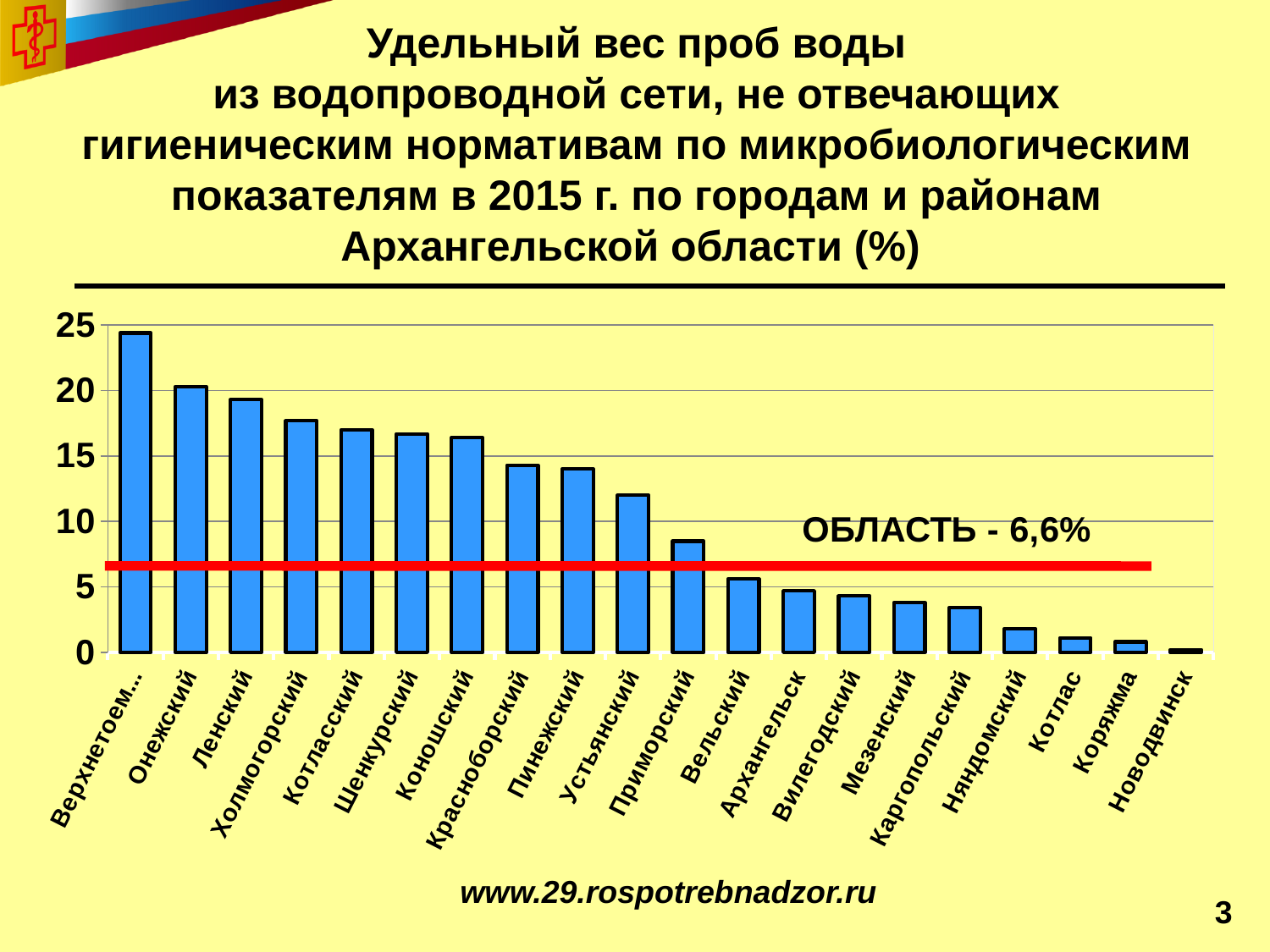
Is the value for Ленский greater or less than 20? less What value for the region (ОБЛАСТЬ) is marked by the red line? 6,6% Do the bar values rise or fall from left to right along the x axis? fall What kind of chart is shown on the slide? bar chart Which has the larger value, Онежский or Холмогорский? Онежский Is the value for Котлас greater or less than 5? less Which has the larger value, Пинежский or Приморский? Пинежский Is the value for Приморский greater or less than 10? less Which city or district has the lowest value in the chart? Новодвинск How many cities and districts are shown on the x axis of the chart? 20